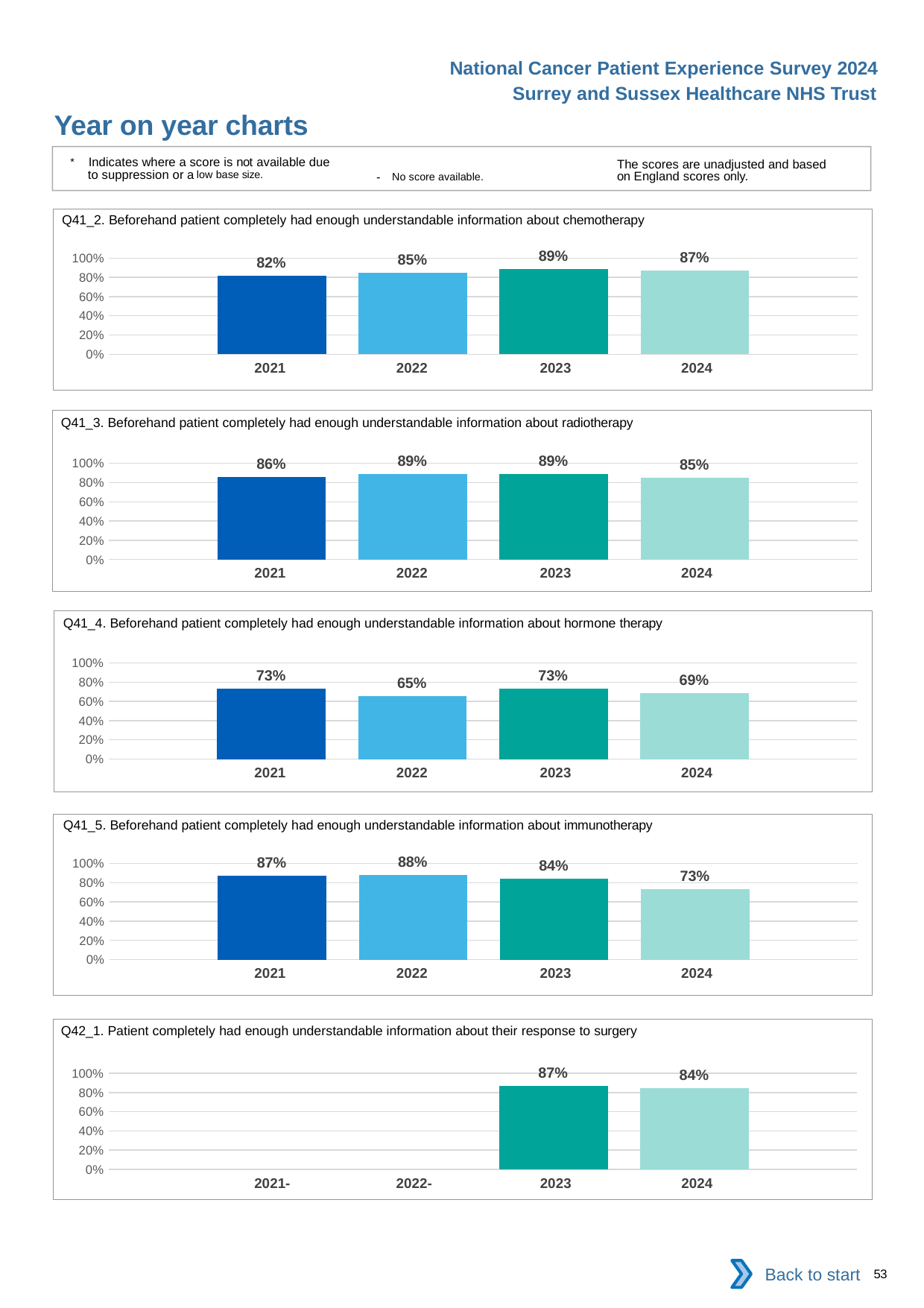
In the Q41_4 hormone therapy chart, which year has the lowest value? 2022 In the Q41_3 radiotherapy chart, what is the difference between the 2022 and 2024 values? 4% In the Q41_2 chemotherapy chart, what is the value for 2023? 89% In the Q41_5 immunotherapy chart, what is the difference between the 2021 and 2024 values? 14% In the Q41_5 immunotherapy chart, which year has the highest value? 2022 What type of chart is the Q41_2 chemotherapy chart? bar chart In the Q41_2 chemotherapy chart, which year has the lowest value? 2021 In the Q42_1 response to surgery chart, which is larger, the 2023 value or the 2024 value? 2023 In the Q41_4 hormone therapy chart, what is the value for 2024? 69% In the Q42_1 response to surgery chart, how many years have a bar plotted? 2 In the Q41_3 radiotherapy chart, what is the value for 2024? 85% In the Q41_5 immunotherapy chart, do the values rise or fall from 2022 to 2024? fall